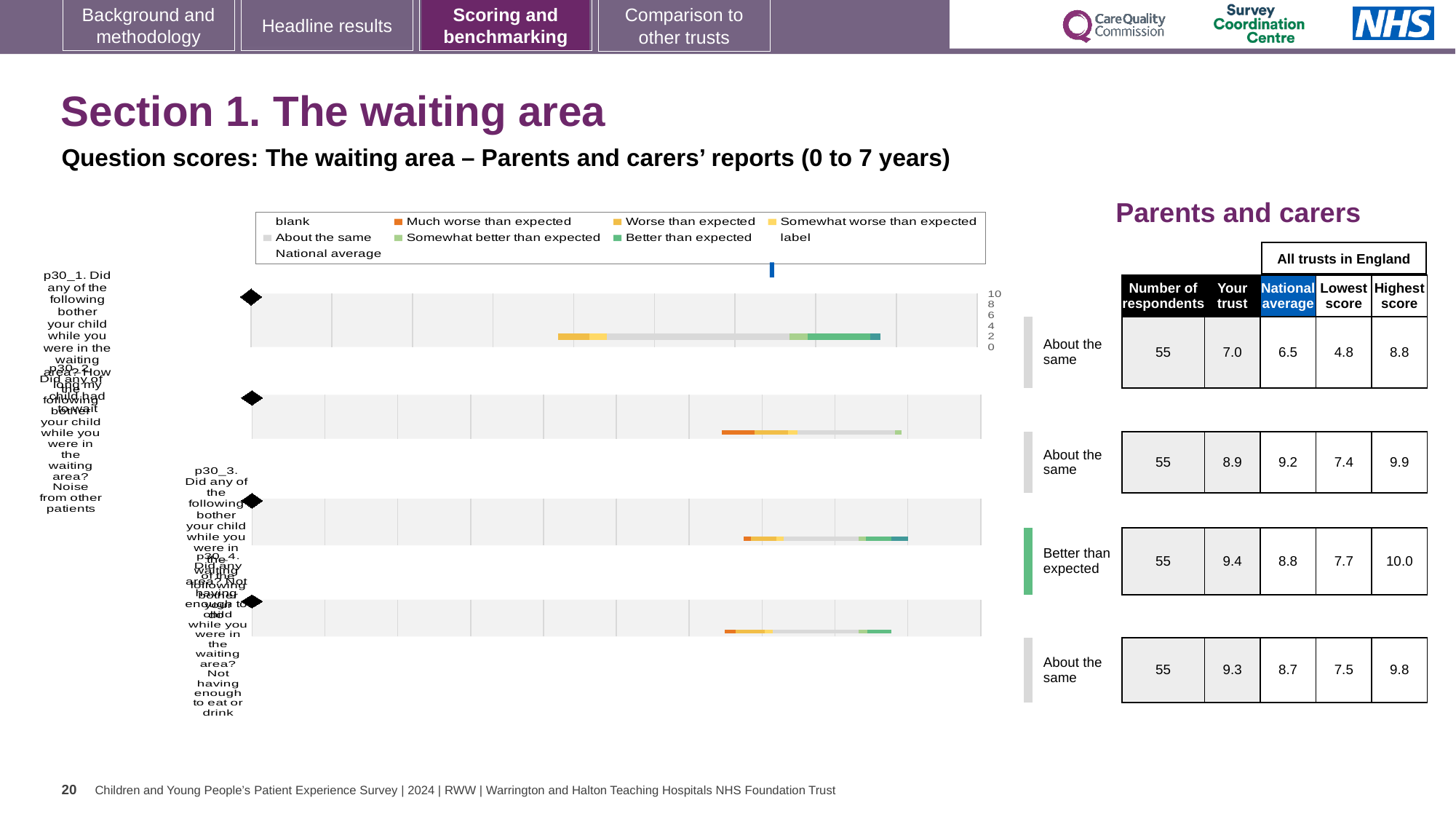
Which row has the highest 'Your trust' score in the table beside the chart? p30_3 (third row), 9.4 For the third row (p30_3), what is the difference between the 'Your trust' score and the national average? 0.6 How many question rows (bars) does the chart show? 4 Which row has the lowest 'Your trust' score in the table beside the chart? p30_1 (first row), 7.0 What is the title of the table to the right of the chart? Parents and carers What kind of chart is shown on the slide? bar chart In the table beside the chart, what is the national average for the second row (p30_2, how long my child had to wait)? 9.2 In the table beside the chart, what is the 'Your trust' score for the first row (p30_1, waiting area)? 7.0 In the table beside the chart, what is the highest score across all trusts in England for the third row (p30_3, noise from other patients)? 10.0 For the first row (p30_1), is the 'Your trust' score higher or lower than the national average? higher In the table beside the chart, how many respondents are listed for the fourth row (p30_4, not having enough to eat or drink)? 55 In the chart legend, what colour represents 'Much worse than expected'? orange